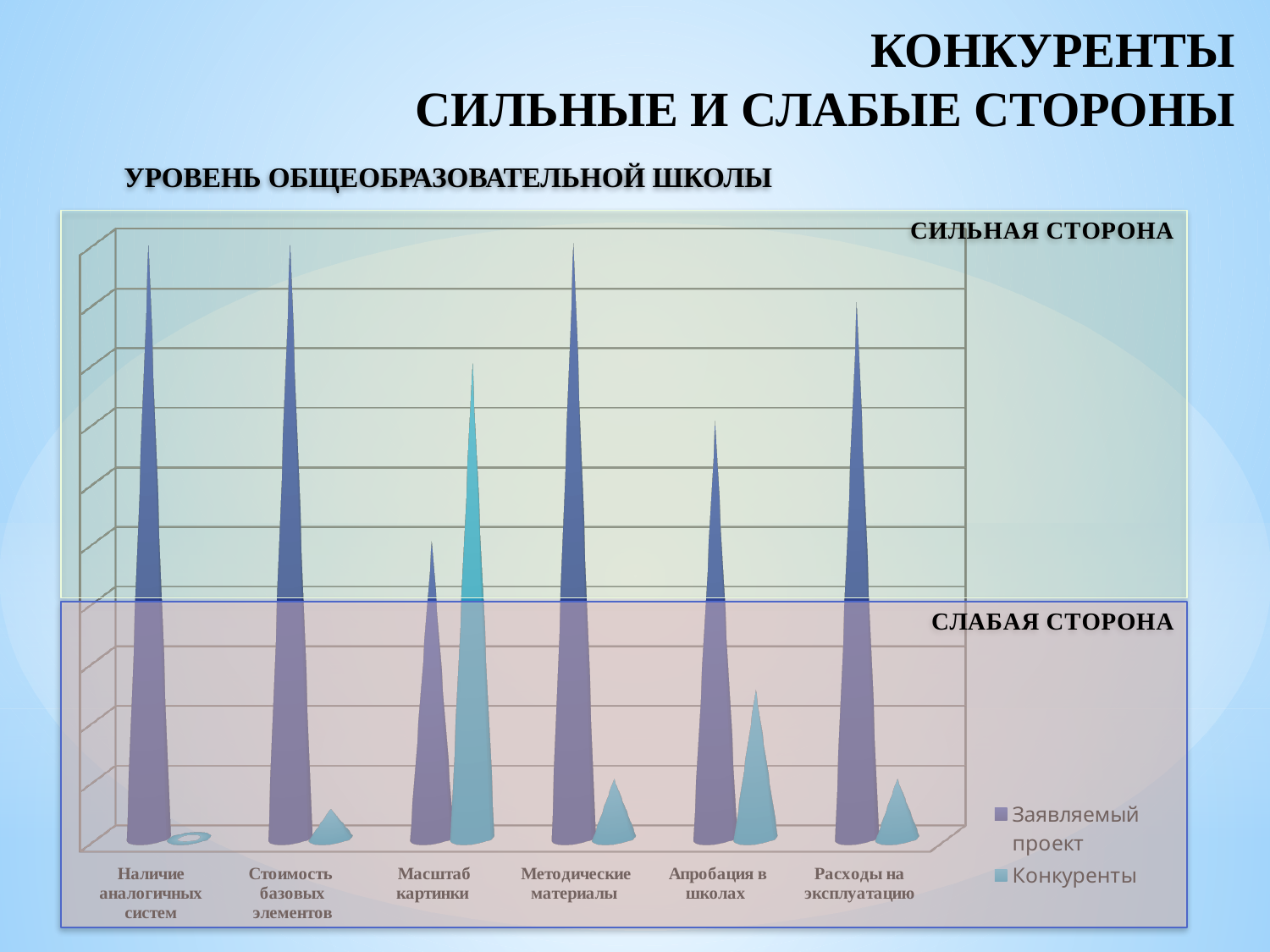
What are the two series names listed in the chart legend? Заявляемый проект; Конкуренты What kind of chart is shown on the slide? Bar chart In the category Апробация в школах, which series has the larger value? Заявляемый проект For the series Заявляемый проект, which category has the lowest value? Масштаб картинки What is the title shown above the chart? УРОВЕНЬ ОБЩЕОБРАЗОВАТЕЛЬНОЙ ШКОЛЫ For the series Конкуренты, which category has the highest value? Масштаб картинки For the series Конкуренты, which is larger: Апробация в школах or Методические материалы? Апробация в школах For the series Заявляемый проект, which is larger: Апробация в школах or Расходы на эксплуатацию? Расходы на эксплуатацию How many categories are shown on the x axis of the chart? 6 How many series does the chart legend list? 2 For the series Конкуренты, which category has the lowest value? Наличие аналогичных систем